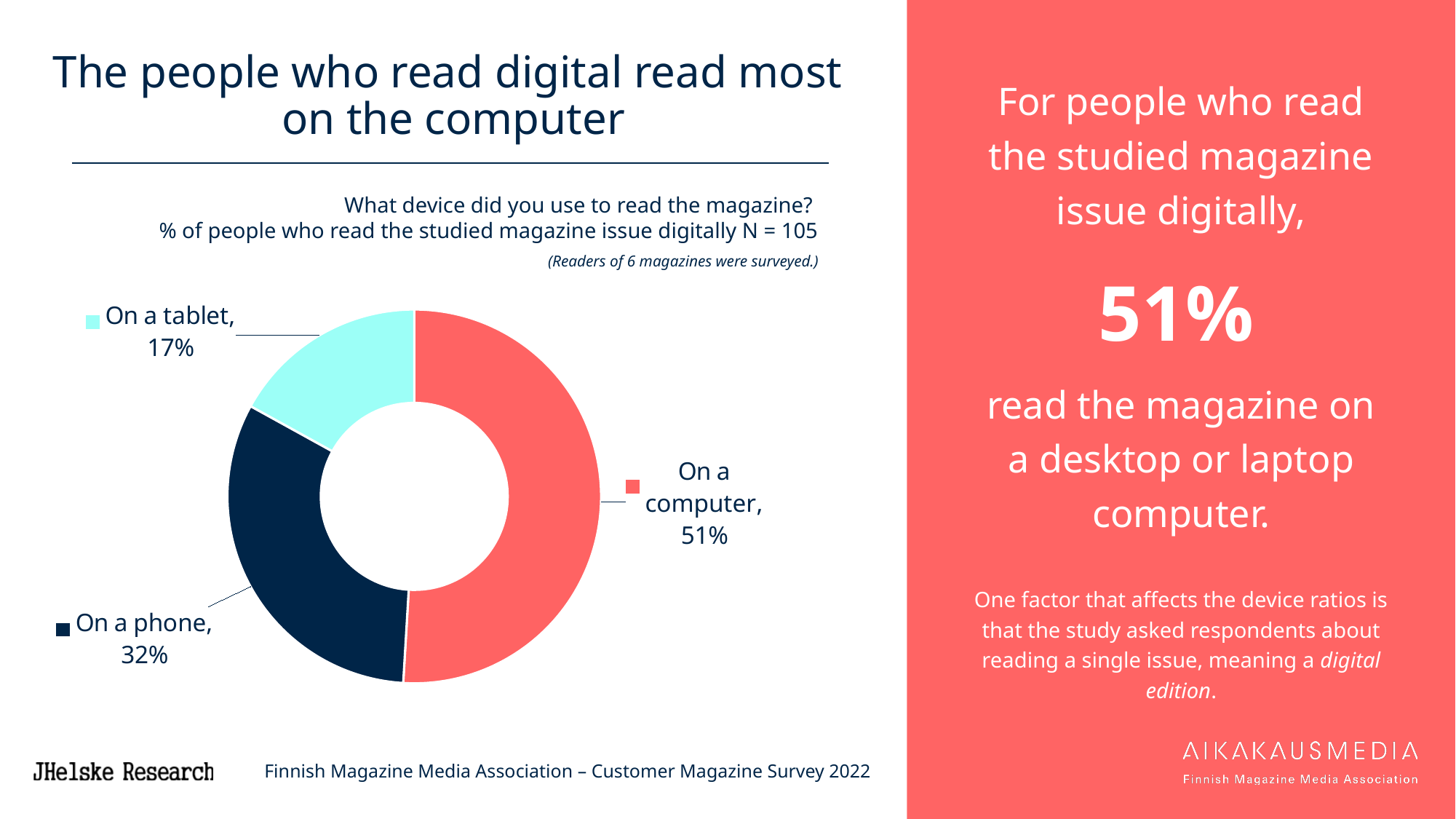
What percentage of digital readers read the magazine on a tablet? 17% What is the sample size (N) stated for the chart? 105 What is the difference in percentage points between the computer share and the phone share? 19 What colour is the segment for 'On a computer'? Red (coral) What kind of chart is shown on the slide? Doughnut (pie) chart What percentage of digital readers read the magazine on a phone? 32% What percentage of digital readers read the magazine on a computer? 51% Which device has the largest share in the chart? On a computer Which device has the smallest share in the chart? On a tablet How many device categories are shown in the chart? 3 Which is larger, the share for phone or the share for tablet? On a phone What is the difference in percentage points between the phone share and the tablet share? 15